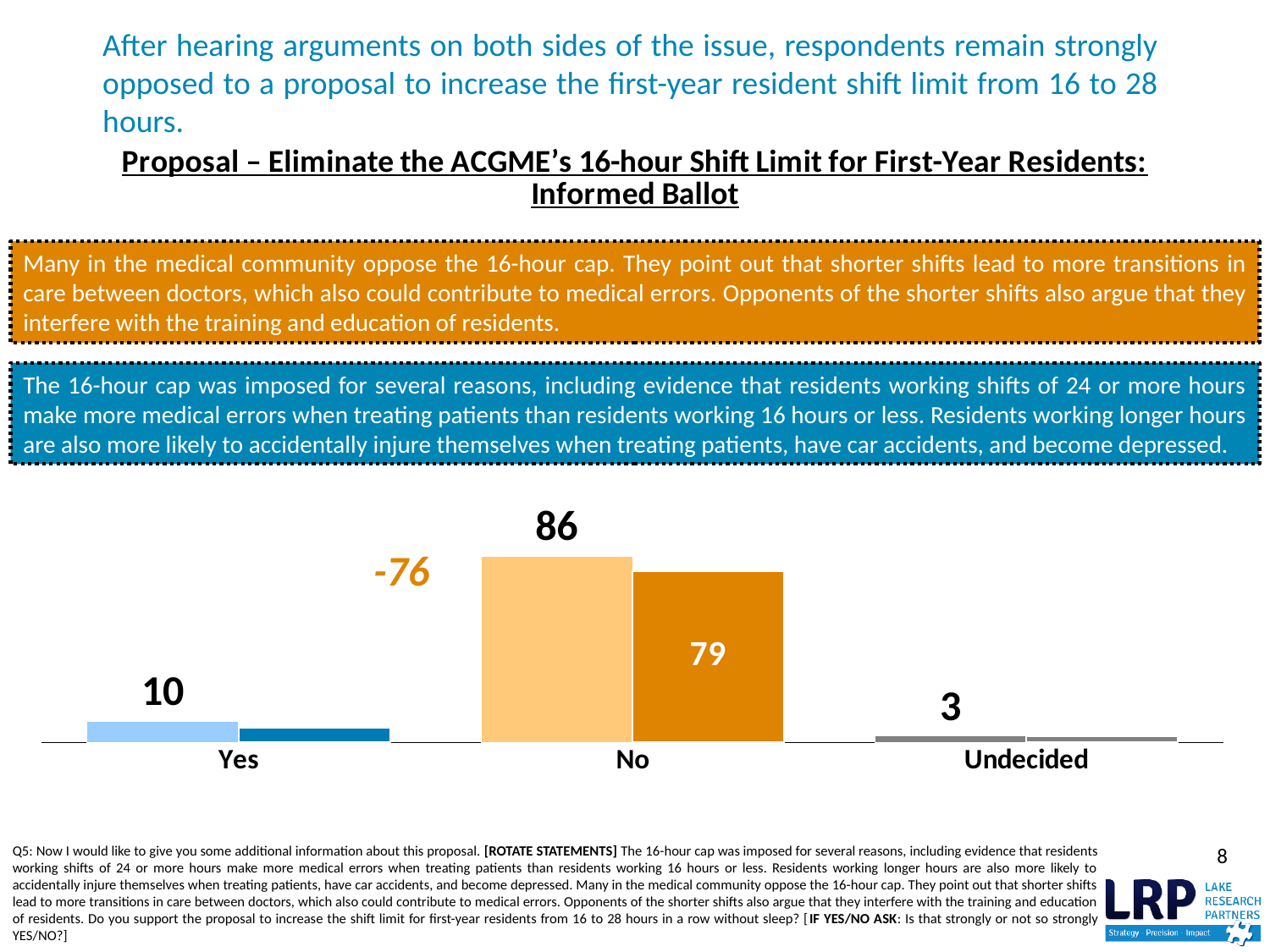
What net figure is printed in orange italics between the Yes and No bars? -76 What value is printed inside the dark orange bar in the No category? 79 What is the value shown for the No category? 86 What is the value shown for the Yes category? 10 What is the value shown for the Undecided category? 3 Which category has the lowest value? Undecided Which is larger, the value for Yes or the value for Undecided? Yes What is the difference between the value for No (86) and the value for Yes (10)? 76 What kind of chart is shown on the slide? Bar chart What is the difference between the two labeled values in the No category, 86 and 79? 7 How many categories are shown on the x axis of the chart? 3 Which category has the highest value? No